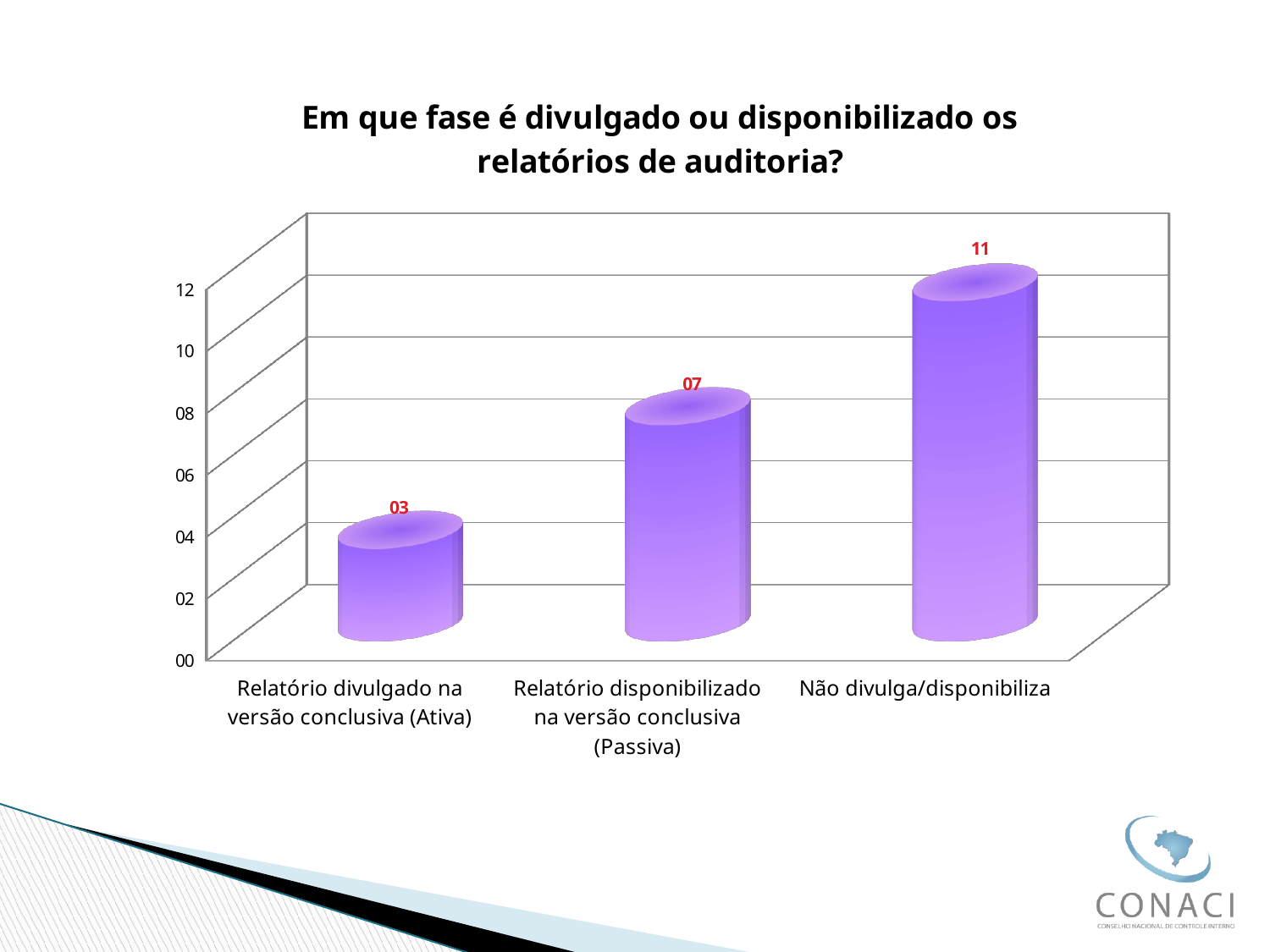
What is the value for "Relatório divulgado na versão conclusiva (Ativa)"? 03 How many categories are shown in the chart? 3 Which is larger: the value for "Relatório disponibilizado na versão conclusiva (Passiva)" or for "Relatório divulgado na versão conclusiva (Ativa)"? Relatório disponibilizado na versão conclusiva (Passiva) What is the value for "Relatório disponibilizado na versão conclusiva (Passiva)"? 07 Do the values rise or fall from left to right across the categories? Rise What is the difference between the values for "Relatório disponibilizado na versão conclusiva (Passiva)" and "Relatório divulgado na versão conclusiva (Ativa)"? 04 What is the title of the chart? Em que fase é divulgado ou disponibilizado os relatórios de auditoria? What is the difference between the values for "Não divulga/disponibiliza" and "Relatório divulgado na versão conclusiva (Ativa)"? 08 What kind of chart is shown on the slide? Bar chart Which category has the lowest value? Relatório divulgado na versão conclusiva (Ativa) What is the value for "Não divulga/disponibiliza"? 11 Which category has the highest value? Não divulga/disponibiliza